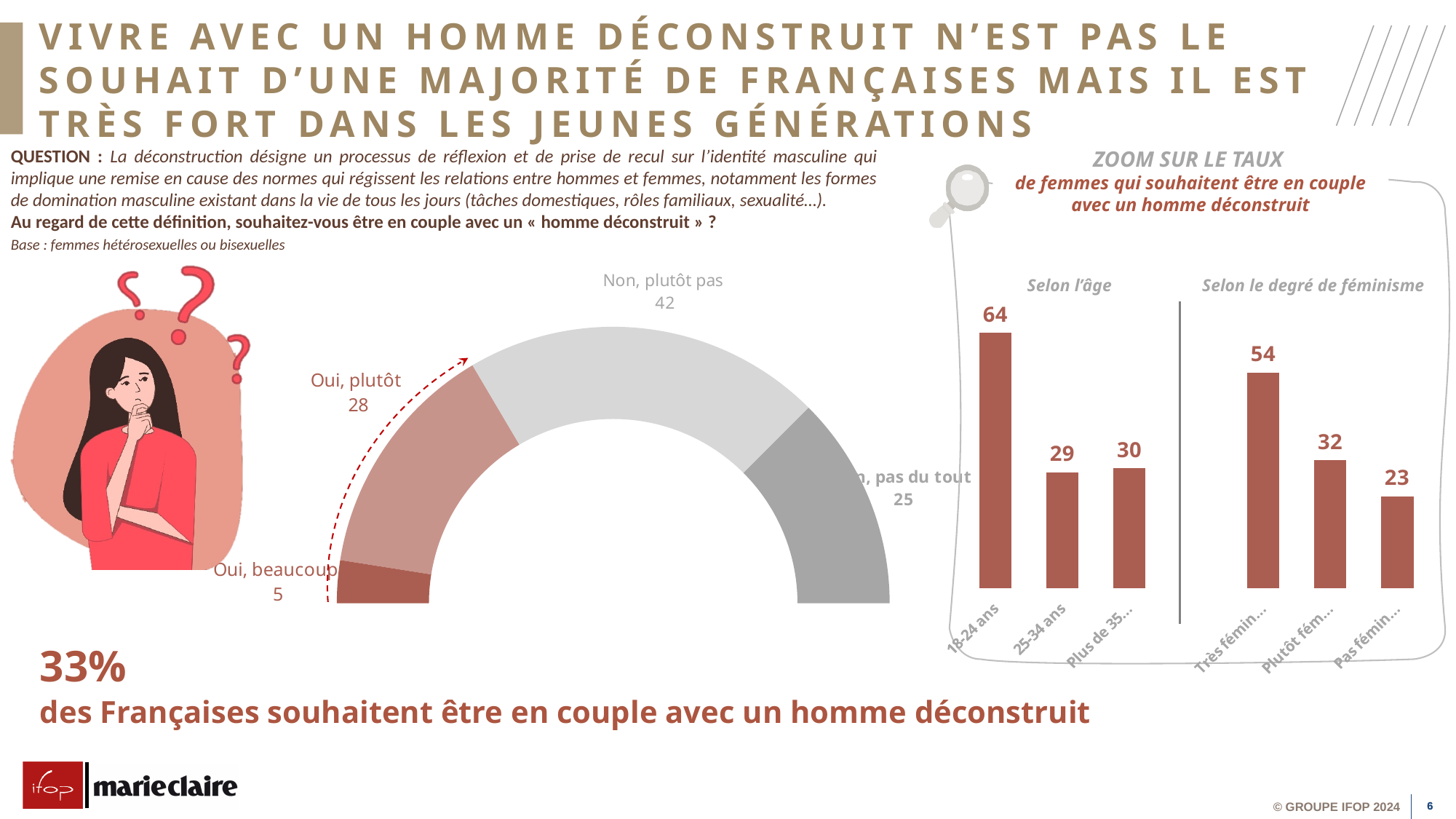
In the bar chart on the right ("Zoom sur le taux"), which category has the highest value? 18-24 ans In the bar chart on the right ("Zoom sur le taux"), how many bars are shown? 6 In the bar chart on the right ("Zoom sur le taux"), what is the value for "25-34 ans"? 29 In the bar chart on the right ("Zoom sur le taux"), what is the difference between the "18-24 ans" bar and the "25-34 ans" bar? 35 In the semicircle chart on the left, how many categories are shown? 4 In the semicircle chart on the left, what is the difference between "Oui, plutôt" and "Oui, beaucoup"? 23 In the bar chart on the right ("Zoom sur le taux"), what is the value for "18-24 ans"? 64 In the semicircle chart on the left, which category has the highest value? Non, plutôt pas In the semicircle chart on the left, which category has the lowest value? Oui, beaucoup In the semicircle chart on the left, what is the value for "Non, plutôt pas"? 42 In the semicircle chart on the left, what is the value for "Oui, beaucoup"? 5 What type of chart is the one on the right under "Zoom sur le taux"? Bar chart